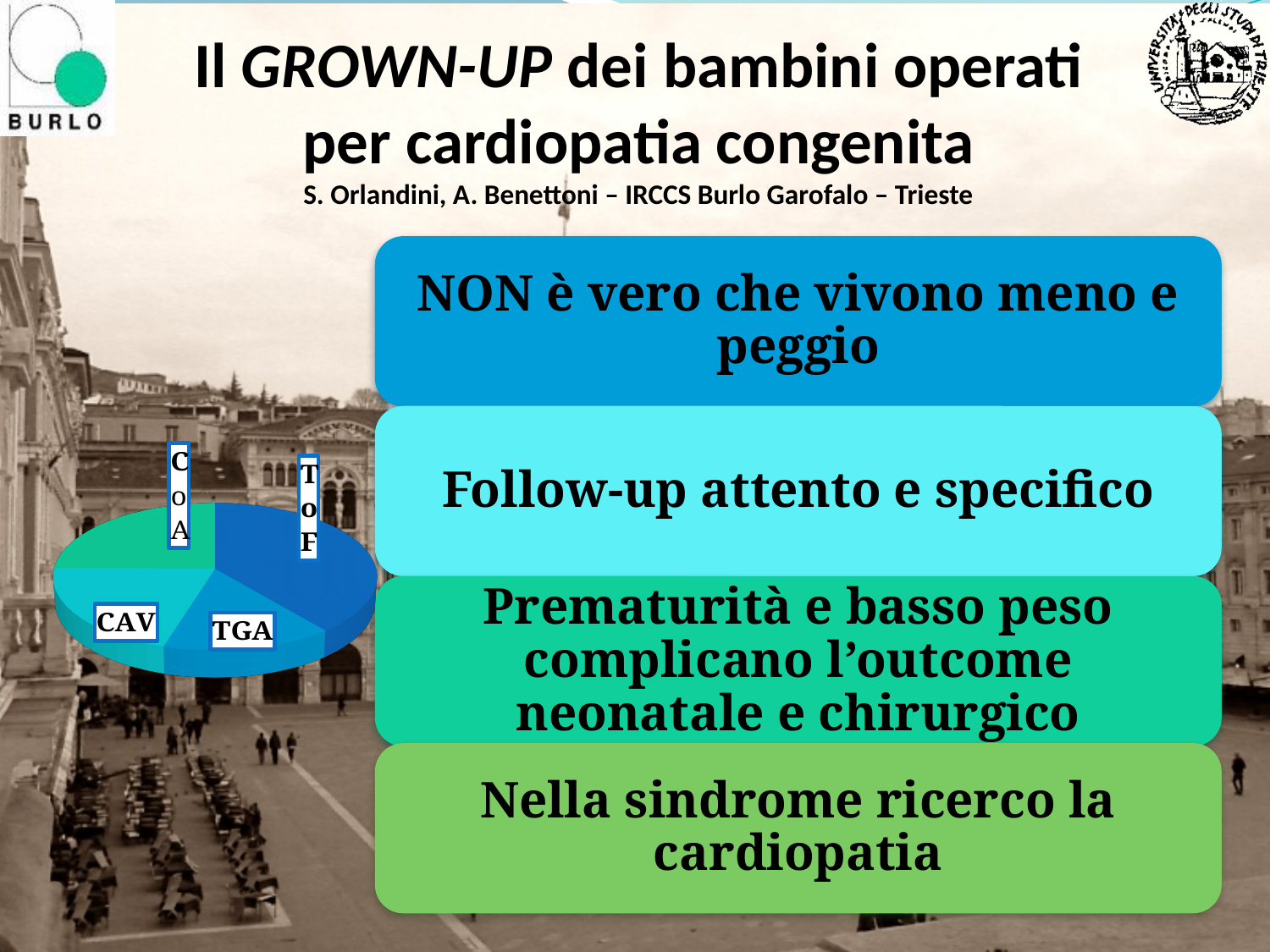
What kind of chart is shown on the left of the slide? pie chart How many labelled slices does the pie chart show? 4 In the pie chart, which slice is larger, ToF or CoA? ToF Which slice of the pie chart is coloured green? CoA Which slice of the pie chart is coloured dark blue? ToF